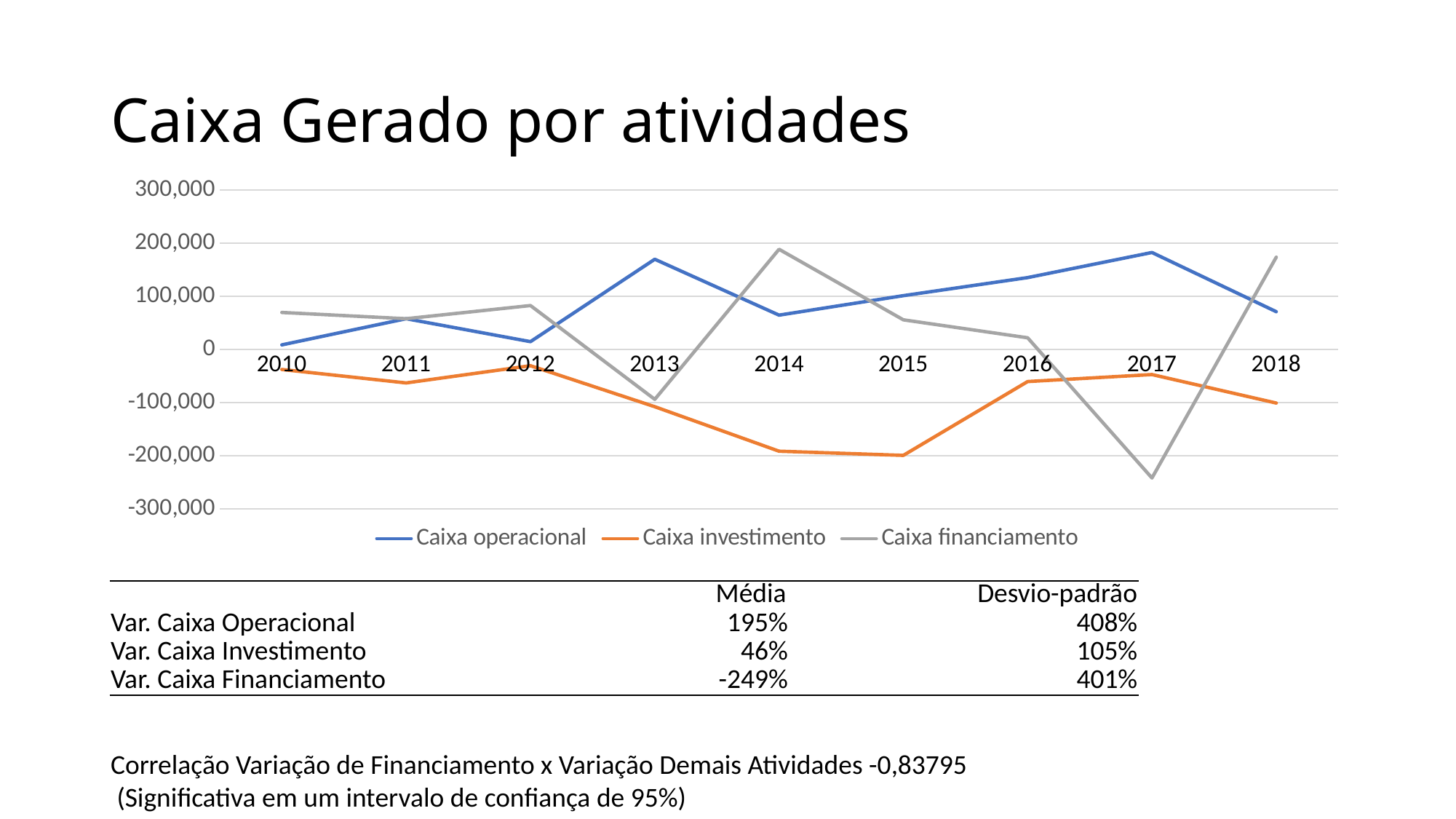
In 2014, which is larger: Caixa financiamento or Caixa operacional? Caixa financiamento What colour is the Caixa investimento line? orange How many years are plotted along the x axis? 9 Is the value for Caixa financiamento in 2017 greater or less than -200,000? less Is the value for Caixa operacional in 2013 greater or less than 100,000? greater Does Caixa investimento rise or fall from 2012 to 2015? fall In which year does Caixa financiamento reach its lowest value? 2017 How many series does the legend list? 3 Is the value for Caixa operacional in 2010 greater or less than 100,000? less In 2013, which is larger: Caixa operacional or Caixa financiamento? Caixa operacional What kind of chart is shown on the slide? line chart